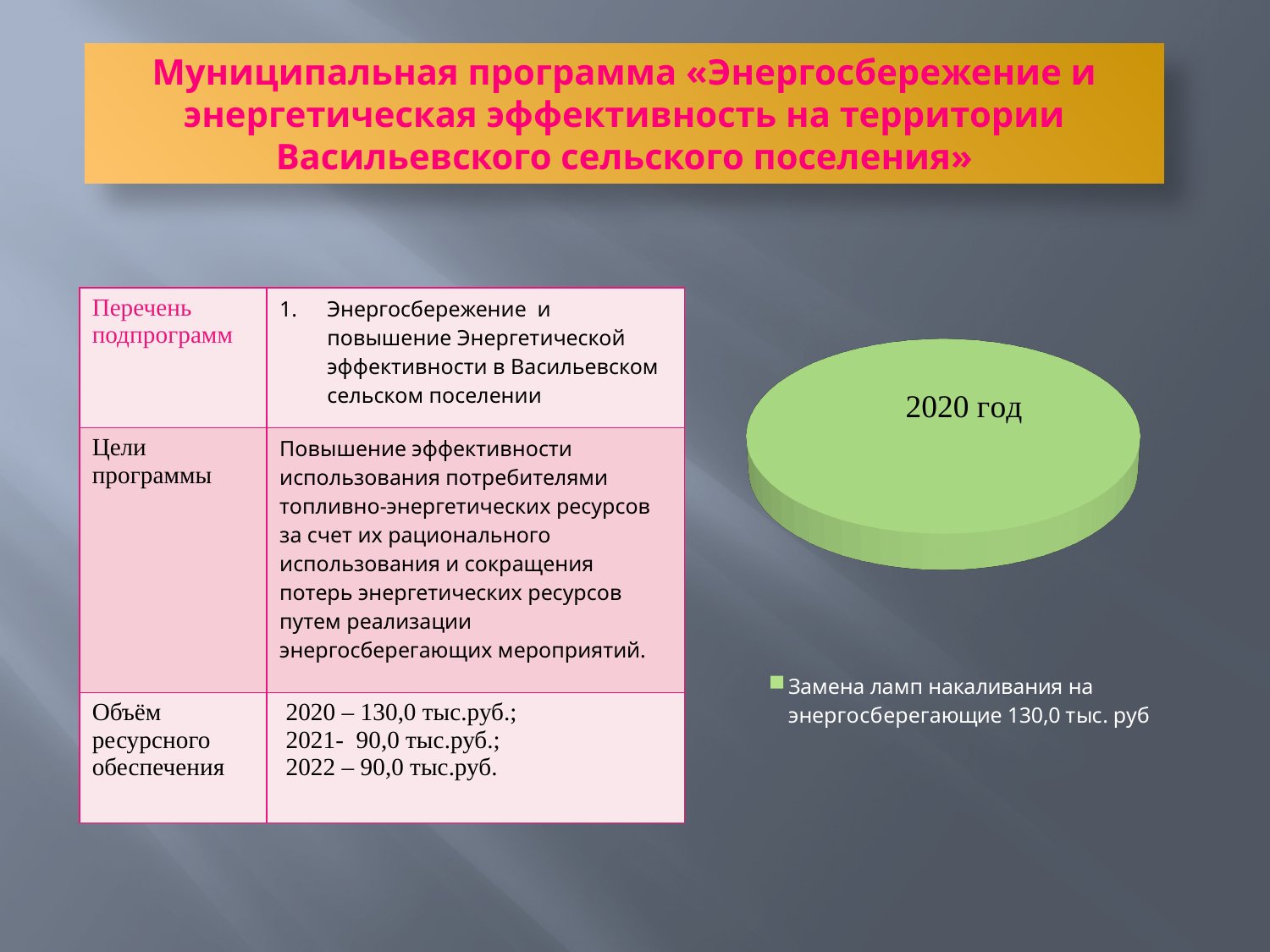
How many entries does the pie chart's legend list? 1 What kind of chart is shown on the right side of the slide? pie chart What is the legend entry of the pie chart? Замена ламп накаливания на энергосберегающие 130,0 тыс. руб What share of the pie does the slice "Замена ламп накаливания на энергосберегающие" take up? 100% How many slices does the pie chart have? 1 What amount is stated in the legend for "Замена ламп накаливания на энергосберегающие"? 130,0 тыс. руб What is the title of the pie chart? 2020 год